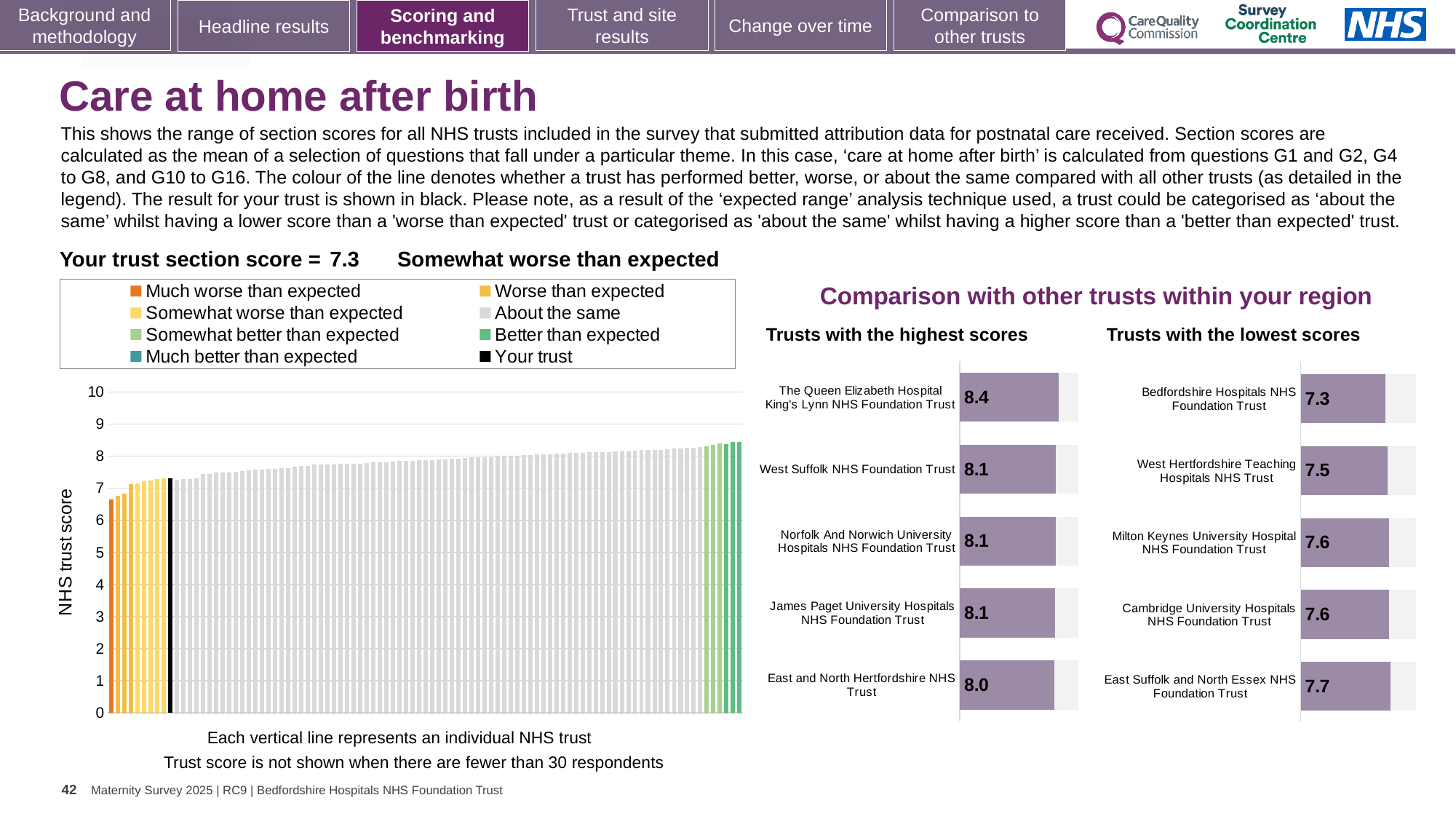
In the 'Trusts with the highest scores' chart, what is the score for East and North Hertfordshire NHS Trust? 8.0 In the 'Trusts with the lowest scores' chart, which has the higher score: Milton Keynes University Hospital NHS Foundation Trust or Bedfordshire Hospitals NHS Foundation Trust? Milton Keynes University Hospital NHS Foundation Trust In the 'Trusts with the lowest scores' chart, which trust has the lowest score? Bedfordshire Hospitals NHS Foundation Trust In the 'Trusts with the highest scores' chart, which trust has the highest score? The Queen Elizabeth Hospital King's Lynn NHS Foundation Trust In the 'Trusts with the highest scores' chart, what is the difference between the scores of The Queen Elizabeth Hospital King's Lynn NHS Foundation Trust and West Suffolk NHS Foundation Trust? 0.3 In the main 'NHS trust score' chart, do the bar values rise or fall from left to right? rise In the 'Trusts with the lowest scores' chart, what is the score for West Hertfordshire Teaching Hospitals NHS Trust? 7.5 In the 'Trusts with the lowest scores' chart, what is the difference between the scores of East Suffolk and North Essex NHS Foundation Trust and Bedfordshire Hospitals NHS Foundation Trust? 0.4 How many trusts are shown in the 'Trusts with the highest scores' chart? 5 In the main 'NHS trust score' chart, what is the section score for your trust (the black bar)? 7.3 In the 'Trusts with the highest scores' chart, what is the score for The Queen Elizabeth Hospital King's Lynn NHS Foundation Trust? 8.4 How many entries does the legend above the main 'NHS trust score' chart list? 8